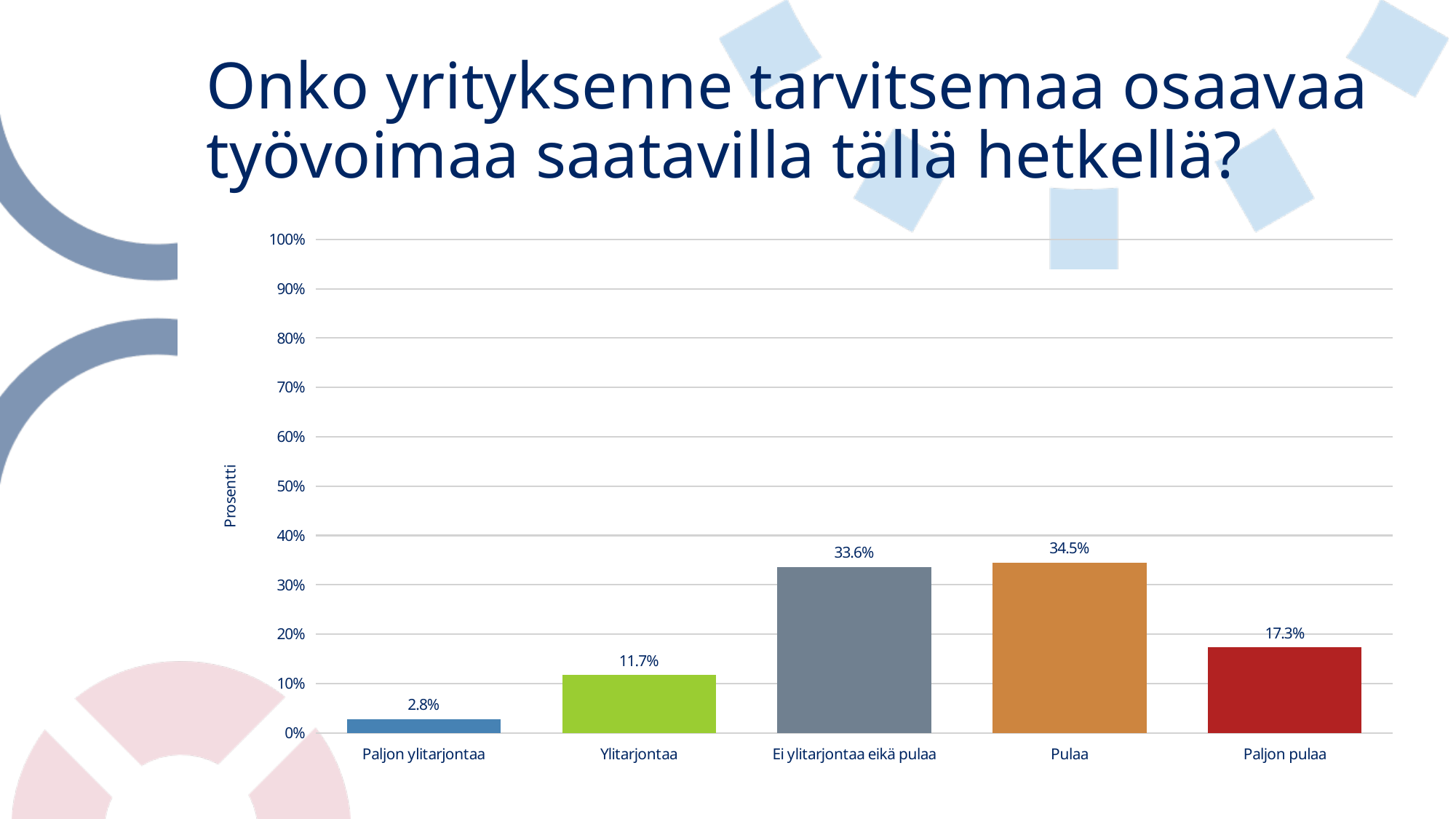
What is the difference between the values for Pulaa and Paljon pulaa? 17.2% What is the label of the vertical axis? Prosentti How many categories are shown on the x axis? 5 What is the value for Paljon pulaa? 17.3% What is the value for Ylitarjontaa? 11.7% Which is larger, the value for Ylitarjontaa or the value for Paljon pulaa? Paljon pulaa What kind of chart is shown on the slide? bar chart Is the value for Ei ylitarjontaa eikä pulaa greater or less than 30%? greater What is the value for Paljon ylitarjontaa? 2.8% Which category has the highest value? Pulaa Which category has the lowest value? Paljon ylitarjontaa What is the value for Ei ylitarjontaa eikä pulaa? 33.6%